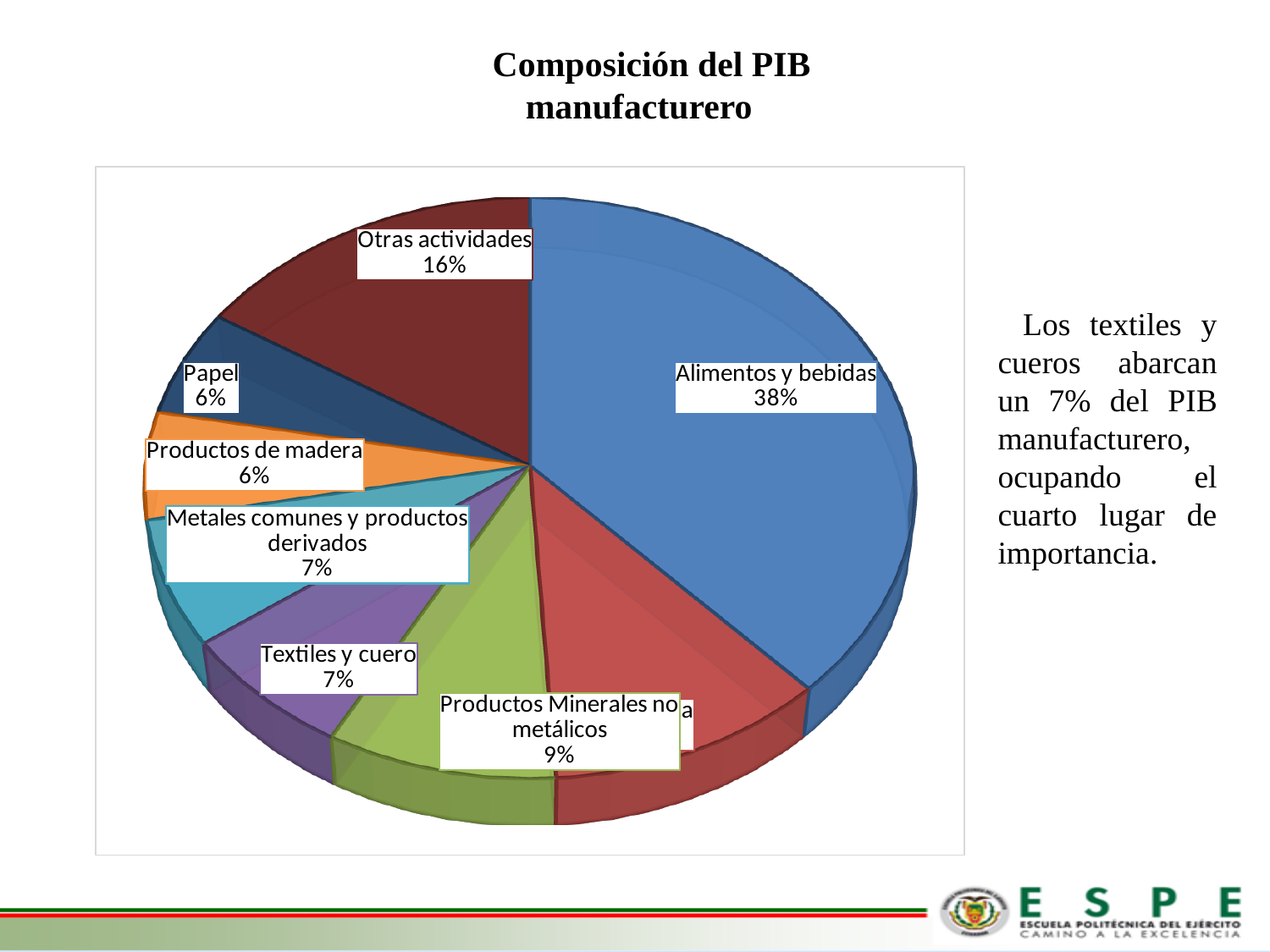
Which is larger, Otras actividades or Productos Minerales no metálicos? Otras actividades What is the value shown for Productos de madera? 6% What is the title of the chart? Composición del PIB manufacturero What kind of chart is shown on the slide? Pie chart What is the value shown for Otras actividades? 16% What share of the pie does Alimentos y bebidas represent? 38% What is the value shown for Textiles y cuero? 7% What is the value shown for Productos Minerales no metálicos? 9% What is the value shown for Papel? 6% What is the difference in percentage points between Alimentos y bebidas and Otras actividades? 22 What is the value shown for Metales comunes y productos derivados? 7% Which category has the largest slice of the pie? Alimentos y bebidas